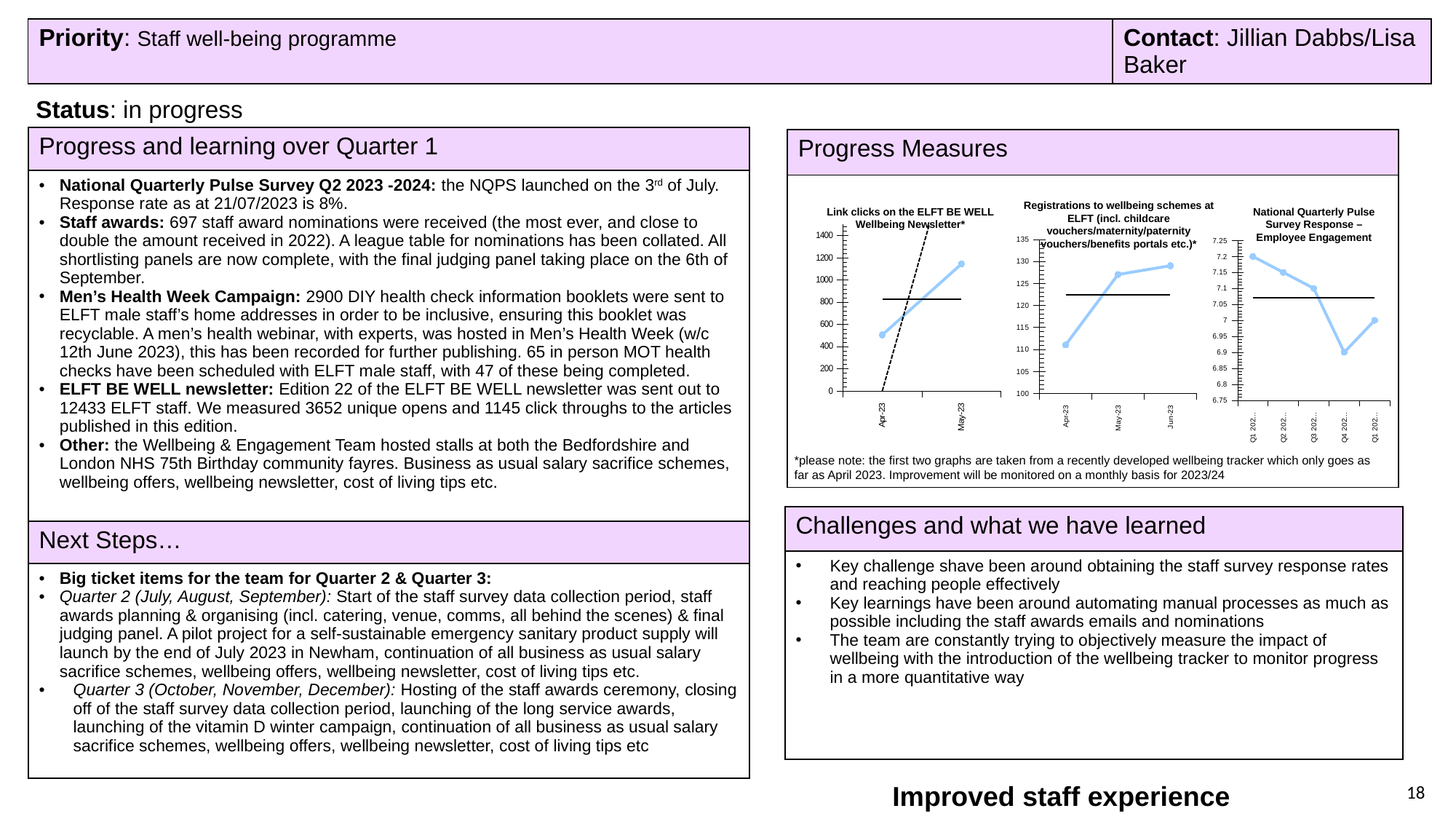
On the 'National Quarterly Pulse Survey Response – Employee Engagement' chart, which is larger, the first point (Q1) or the fourth point (Q4)? the first point (Q1) On the 'Registrations to wellbeing schemes at ELFT' chart, is the value for Apr-23 greater or less than 115? less On the 'Link clicks on the ELFT BE WELL Wellbeing Newsletter' chart, do the values rise or fall from Apr-23 to May-23? rise On the 'National Quarterly Pulse Survey Response – Employee Engagement' chart, is the value for the fourth point (Q4) greater or less than 6.95? less On the 'Link clicks on the ELFT BE WELL Wellbeing Newsletter' chart, is the value for May-23 greater or less than 1000? greater How many data points are plotted on the 'Link clicks on the ELFT BE WELL Wellbeing Newsletter' chart? 2 What kind of chart is the 'Link clicks on the ELFT BE WELL Wellbeing Newsletter' chart? line chart On the 'Registrations to wellbeing schemes at ELFT' chart, which is larger, the value for Apr-23 or the value for Jun-23? Jun-23 How many months are plotted on the 'Registrations to wellbeing schemes at ELFT' chart? 3 How many data points are plotted on the 'National Quarterly Pulse Survey Response – Employee Engagement' chart? 5 On the 'Registrations to wellbeing schemes at ELFT' chart, which month has the lowest value? Apr-23